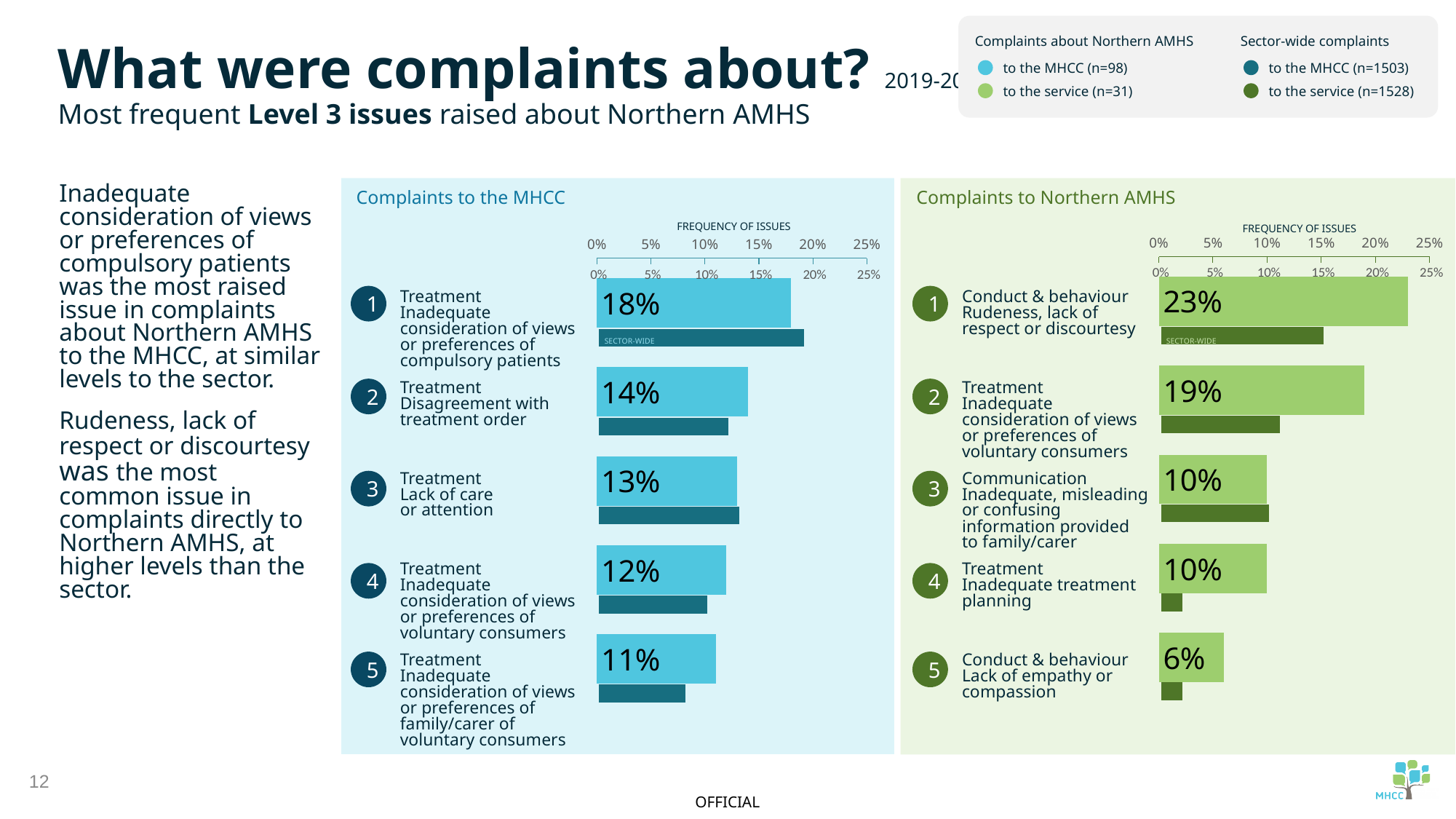
How many issues are listed in the 'Complaints to the MHCC' chart? 5 In the 'Complaints to Northern AMHS' chart, what is the value for 'Conduct & behaviour – Rudeness, lack of respect or discourtesy'? 23% In the 'Complaints to the MHCC' chart, which issue has the lowest frequency? Treatment – Inadequate consideration of views or preferences of family/carer of voluntary consumers In the 'Complaints to Northern AMHS' chart, which issue has the highest frequency? Conduct & behaviour – Rudeness, lack of respect or discourtesy In the 'Complaints to the MHCC' chart, what is the difference between the values for 'Treatment – Inadequate consideration of views or preferences of compulsory patients' and 'Treatment – Disagreement with treatment order'? 4% Which is larger: the value for 'Treatment – Inadequate consideration of views or preferences of voluntary consumers' in the 'Complaints to the MHCC' chart or in the 'Complaints to Northern AMHS' chart? Complaints to Northern AMHS In the 'Complaints to Northern AMHS' chart, what is the value for 'Conduct & behaviour – Lack of empathy or compassion'? 6% In the 'Complaints to the MHCC' chart, what is the value for 'Treatment – Inadequate consideration of views or preferences of compulsory patients'? 18% In the 'Complaints to Northern AMHS' chart, what is the difference between the values for 'Conduct & behaviour – Rudeness, lack of respect or discourtesy' and 'Treatment – Inadequate consideration of views or preferences of voluntary consumers'? 4% In the 'Complaints to the MHCC' chart, what is the value for 'Treatment – Lack of care or attention'? 13% In the 'Complaints to the MHCC' chart, is the sector-wide value for 'Treatment – Inadequate consideration of views or preferences of compulsory patients' greater or less than 15%? greater In the 'Complaints to Northern AMHS' chart, is the sector-wide value for 'Treatment – Inadequate treatment planning' greater or less than 5%? less